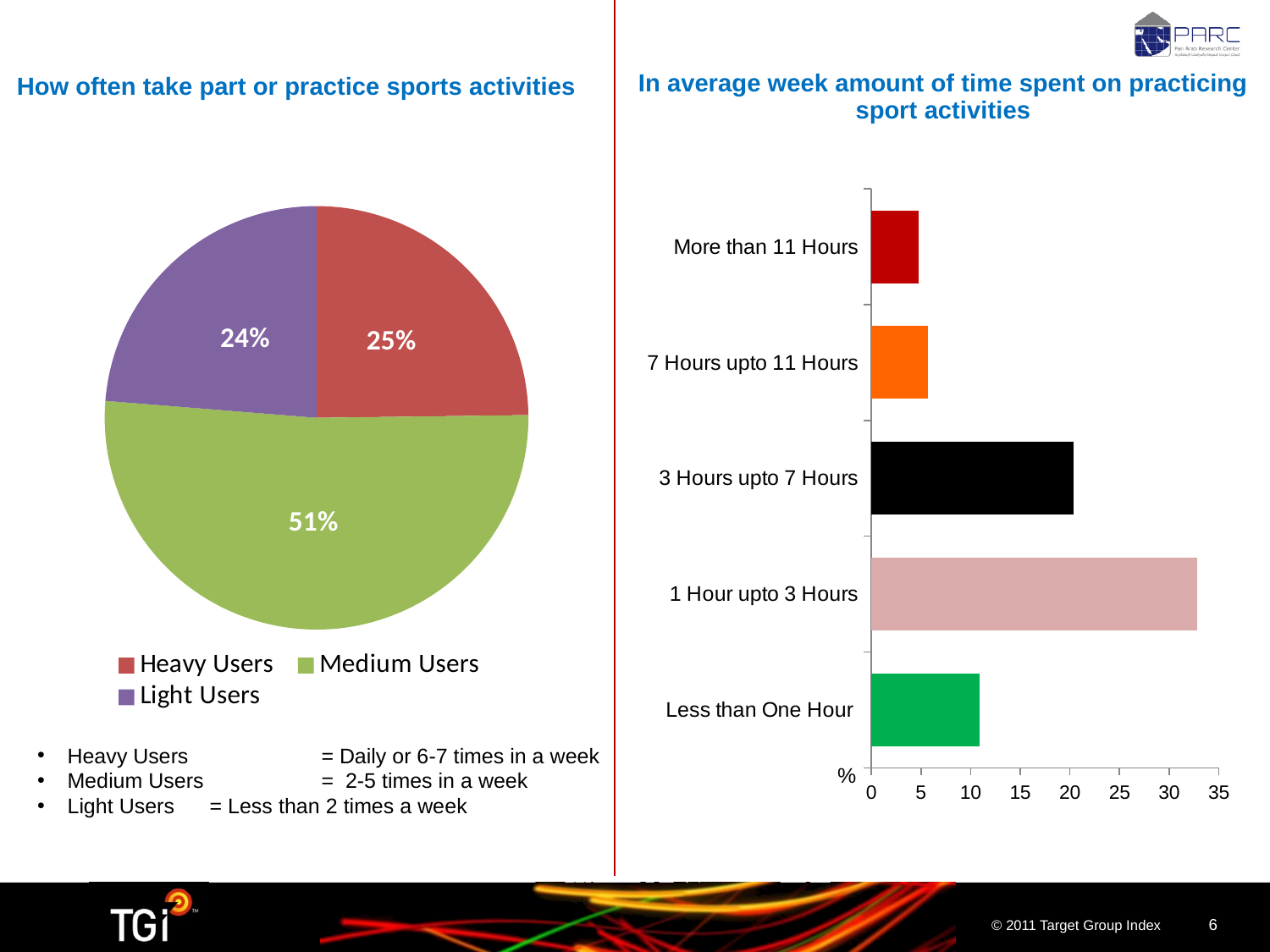
In the pie chart 'How often take part or practice sports activities', what share is Light Users? 24% In the pie chart 'How often take part or practice sports activities', what share is Medium Users? 51% In the pie chart 'How often take part or practice sports activities', how many entries does the legend list? 3 In the pie chart 'How often take part or practice sports activities', what colour is the Light Users slice? Purple In the chart 'In average week amount of time spent on practicing sport activities', is the value for 1 Hour upto 3 Hours greater or less than 30? greater In the chart 'In average week amount of time spent on practicing sport activities', which is larger: 3 Hours upto 7 Hours or Less than One Hour? 3 Hours upto 7 Hours In the chart 'In average week amount of time spent on practicing sport activities', how many categories are shown? 5 In the pie chart 'How often take part or practice sports activities', what share is Heavy Users? 25% In the pie chart 'How often take part or practice sports activities', what is the difference in percentage points between Medium Users and Heavy Users? 26 What kind of chart is 'In average week amount of time spent on practicing sport activities'? Bar chart In the pie chart 'How often take part or practice sports activities', which group has the largest share? Medium Users In the chart 'In average week amount of time spent on practicing sport activities', which category has the highest value? 1 Hour upto 3 Hours